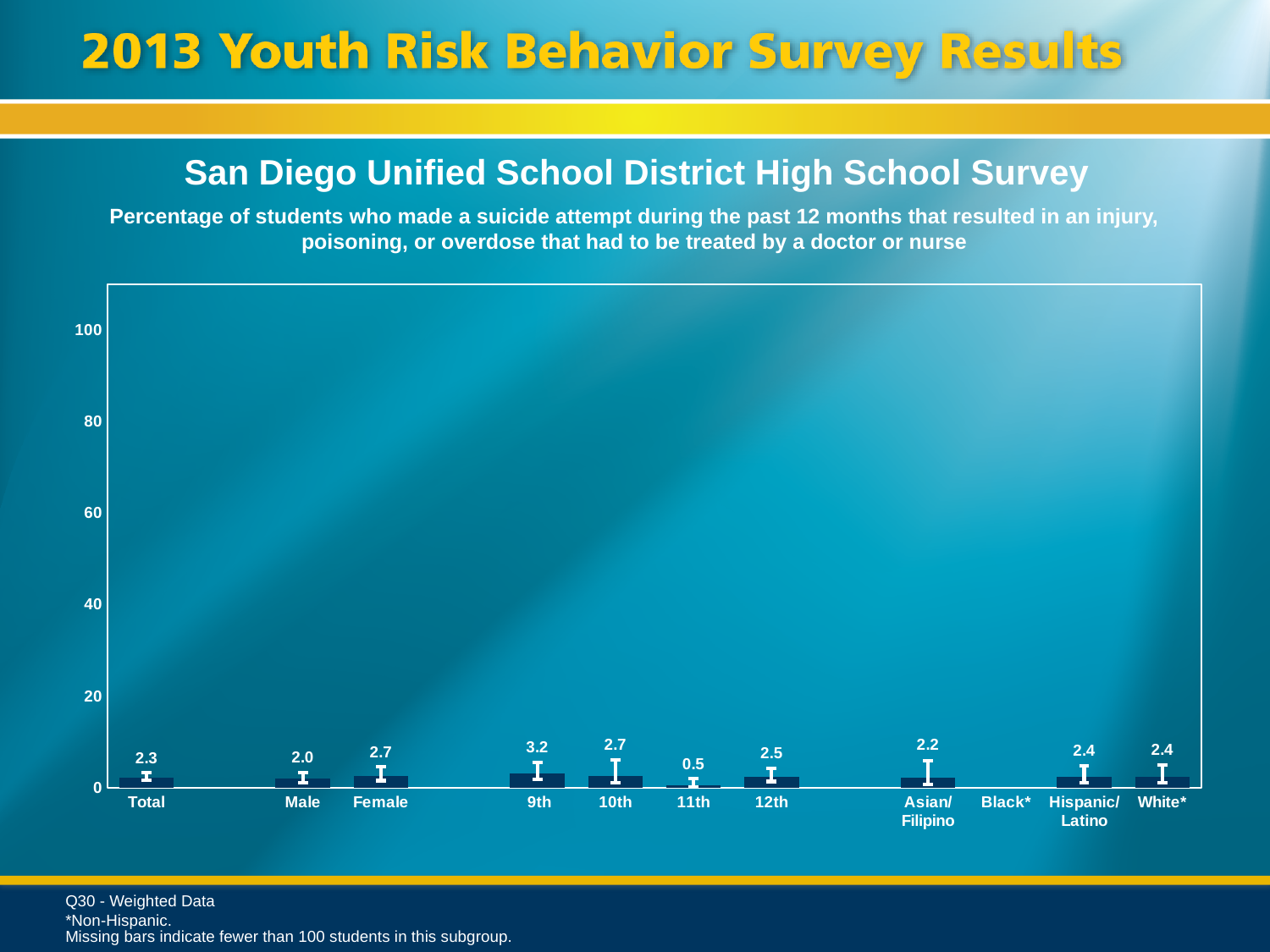
What is the value for Asian/Filipino? 2.2 Which is larger, the value for 9th or the value for 12th? 9th Is the value for 9th greater or less than 20? less Which category has no bar plotted? Black* Which category with a plotted bar has the lowest value? 11th Which category has the highest value? 9th What is the value for Female? 2.7 How many categories are labeled on the x axis? 11 What is the value for Total? 2.3 What is the difference between the values for Female and Male? 0.7 What is the value for 11th grade? 0.5 What kind of chart is shown on the slide? bar chart